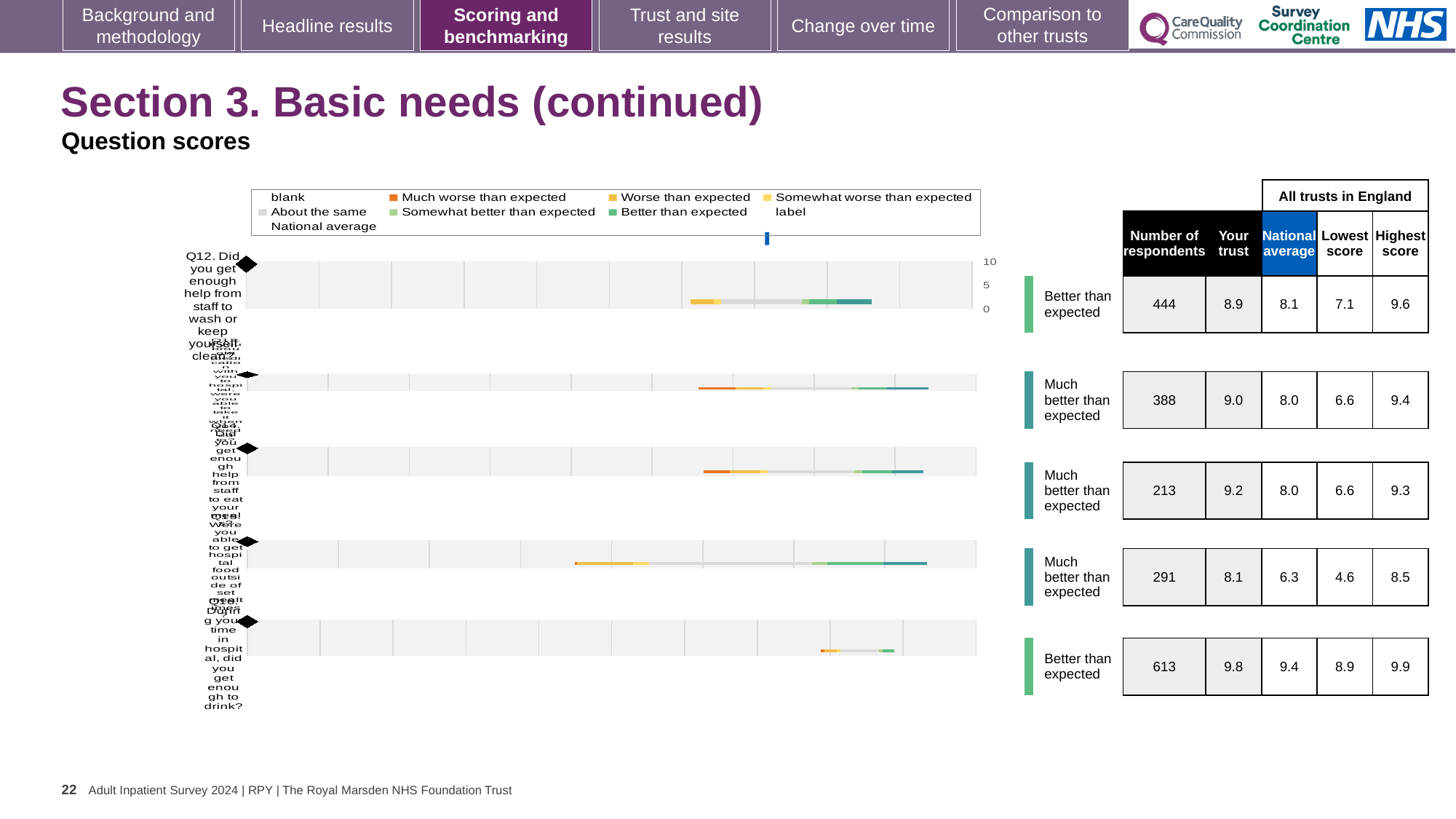
What benchmark category is shown for Q14 (help from staff to eat your meals)? Much better than expected What is the national average score for Q14 (help from staff to eat your meals)? 8.0 Which is larger for Q14 (help from staff to eat your meals): the 'Your trust' score or the national average? Your trust What kind of chart is shown on the slide? bar chart How many question rows are plotted in the chart? 5 Which question row has the lowest 'Your trust' score? Q15 (hospital food outside of set mealtimes) Which question row has the highest 'Your trust' score? Q16 (did you get enough to drink) What benchmark category is shown for Q12 (help from staff to wash or keep yourself clean)? Better than expected What is the difference between the 'Your trust' score and the national average for Q15 (hospital food outside of set mealtimes)? 1.8 What is the 'Your trust' score for Q12 (help from staff to wash or keep yourself clean)? 8.9 How many respondents answered Q12 (help from staff to wash or keep yourself clean)? 444 What is the 'Your trust' score for Q16 (did you get enough to drink)? 9.8